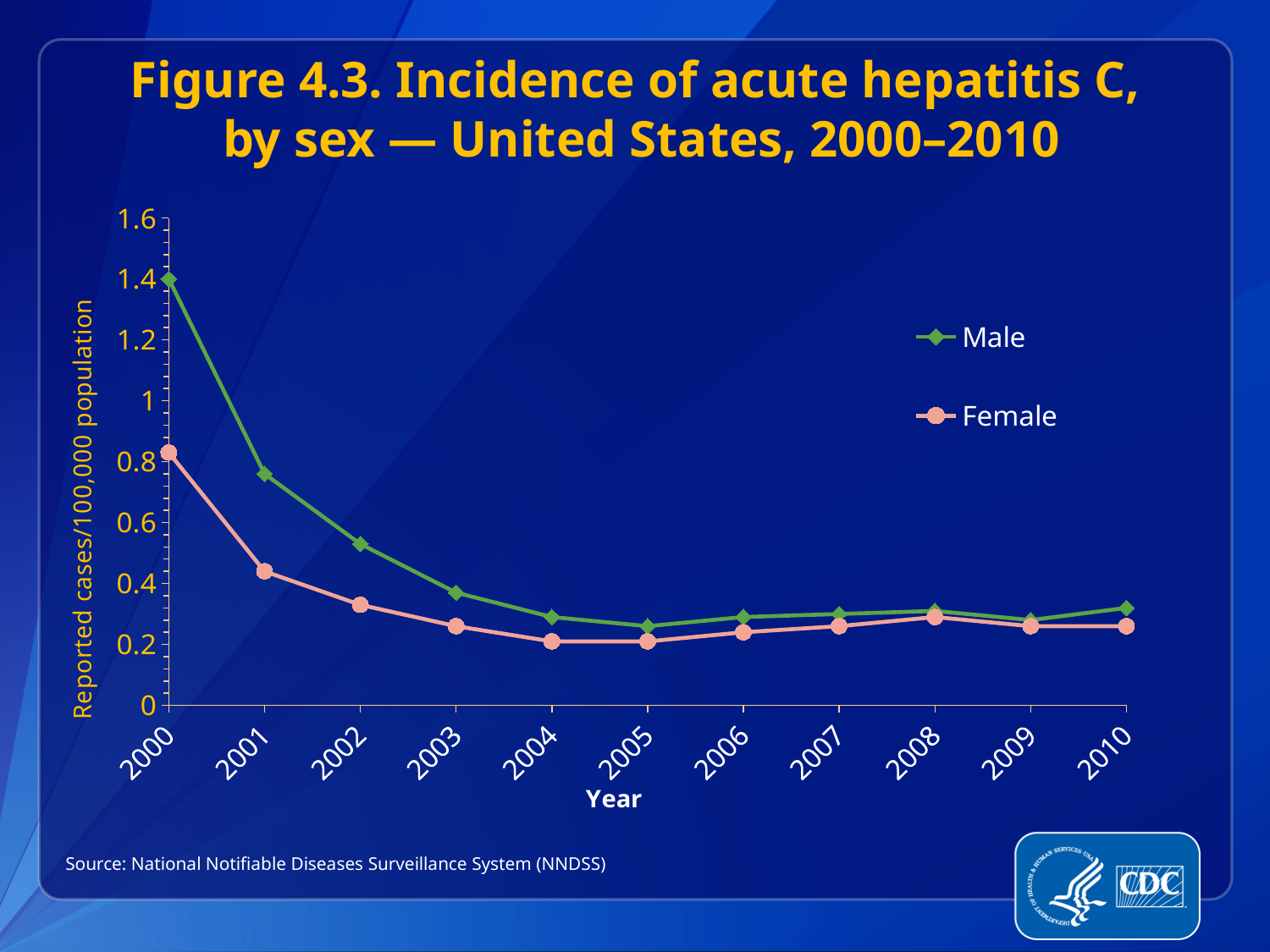
In which year is the Male incidence highest? 2000 What is the label on the y axis? Reported cases/100,000 population In 2000, which series has the larger value, Male or Female? Male What kind of chart is shown on the slide? Line chart Is the Male value for 2000 greater or less than 1.2? greater Is the Female value for 2000 greater or less than 1? less Is the Female value for 2001 greater or less than 0.6? less How many years are plotted along the x axis? 11 Does the Male incidence rise or fall from 2000 to 2004? Fall How many series does the legend list? 2 In which year is the Female incidence highest? 2000